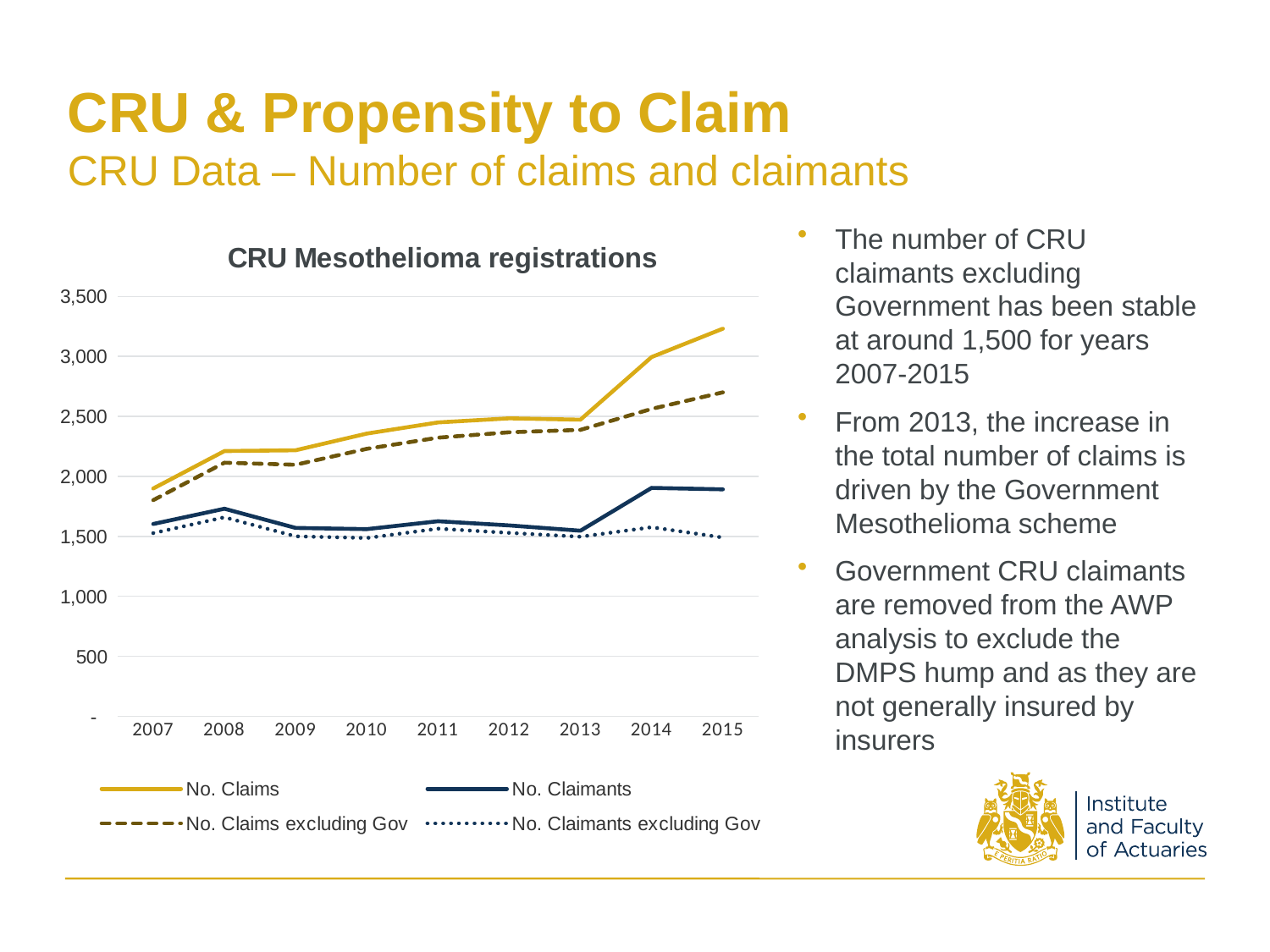
Is the value for No. Claims in 2015 greater or less than 3,000? greater Which series is drawn as a dotted line in the CRU Mesothelioma registrations chart? No. Claimants excluding Gov Is the value for No. Claimants in 2014 greater or less than 1,500? greater In which year is No. Claims highest? 2015 In 2015, which is larger: No. Claims or No. Claims excluding Gov? No. Claims How many years are shown on the x axis of the CRU Mesothelioma registrations chart? 9 Is the value for No. Claims in 2007 greater or less than 2,000? less How many series does the legend of the CRU Mesothelioma registrations chart list? 4 In which year is No. Claims lowest? 2007 What kind of chart is the CRU Mesothelioma registrations chart? Line chart Does No. Claims rise or fall from 2013 to 2015? Rise In which year is No. Claims excluding Gov highest? 2015